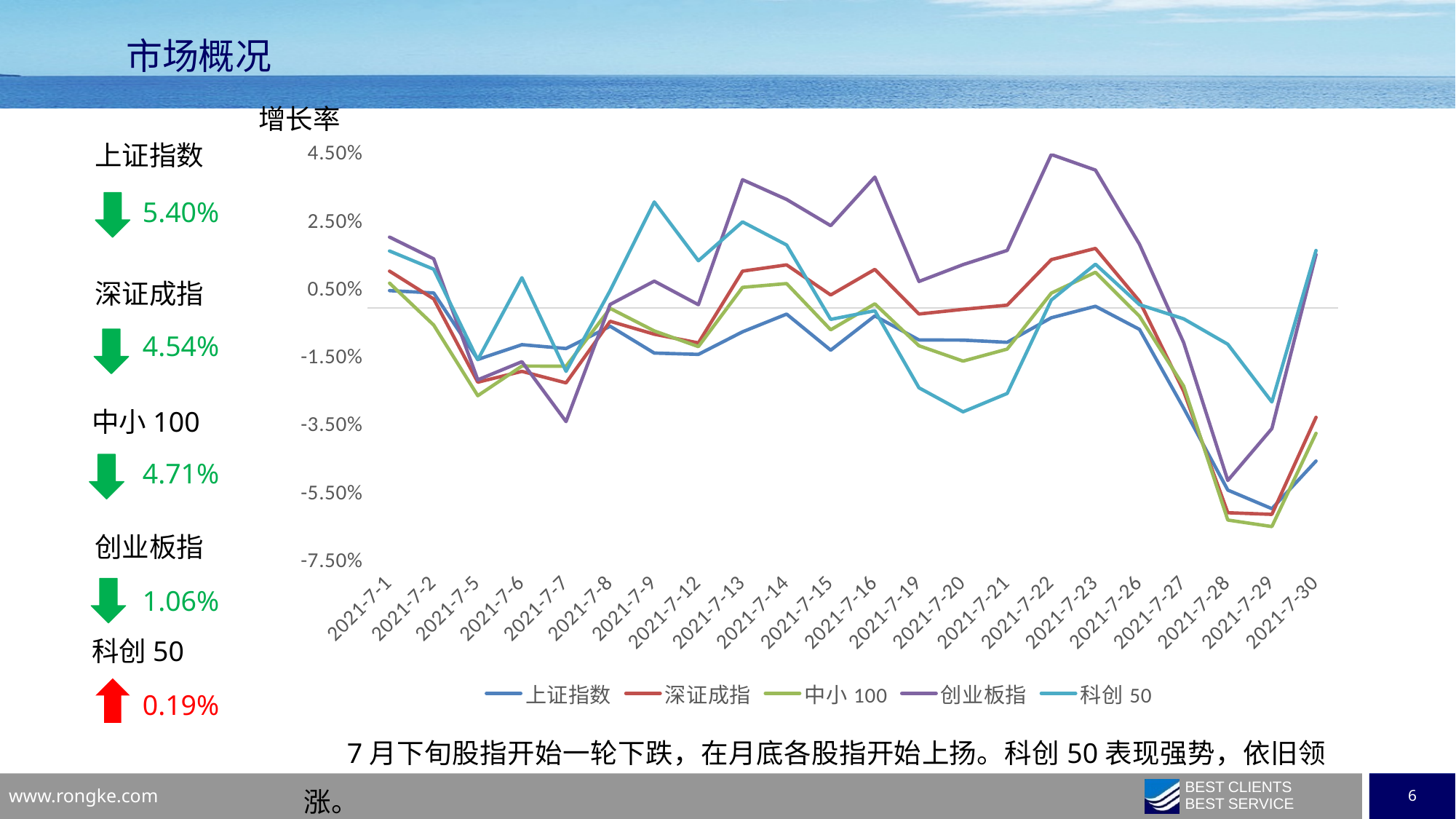
How many series does the chart legend list? 5 Is the value for 上证指数 on 2021-7-28 greater or less than -3.50%? less Which series has the highest value on 2021-7-9? 科创 50 On 2021-7-29, which is higher: 科创 50 or 上证指数? 科创 50 Is the value for 创业板指 on 2021-7-22 greater or less than 2.50%? greater What is the label shown on the vertical axis of the chart? 增长率 Which series has the lowest value on 2021-7-7? 创业板指 Do the series rise or fall from 2021-7-23 to 2021-7-28? fall Which series has the highest value on 2021-7-22? 创业板指 How many dates are shown along the x axis of the chart? 22 What kind of chart is shown on the slide? line chart Is the value for 科创 50 on 2021-7-20 greater or less than -1.50%? less